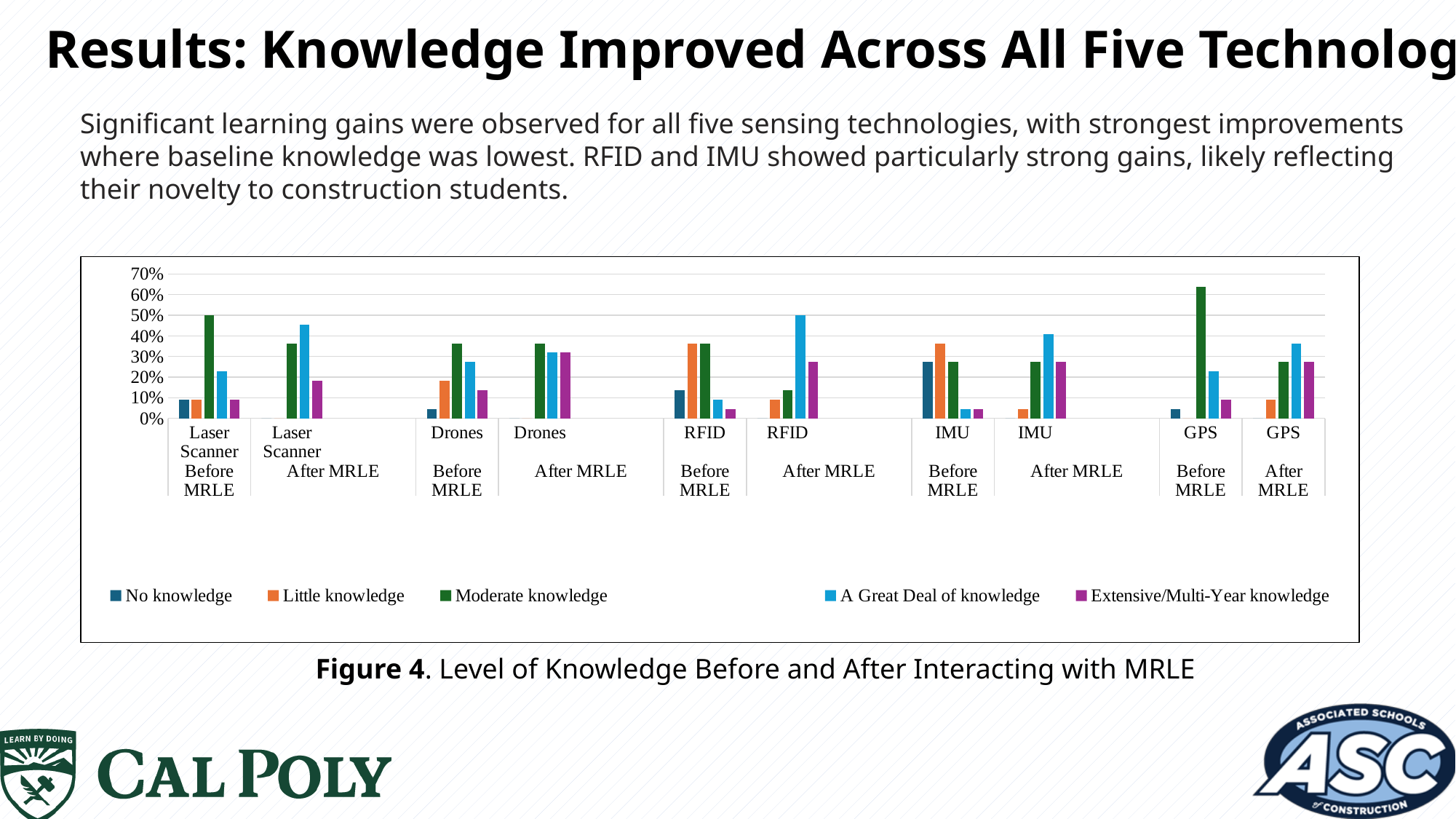
How many series does the chart legend list? 5 Which category group contains the tallest bar in the chart? GPS Before MRLE What kind of chart is shown on the slide? Bar chart Which series has the highest value for GPS Before MRLE? Moderate knowledge How many category groups are shown along the x axis of the chart? 10 Is the A Great Deal of knowledge value for Laser Scanner After MRLE greater or less than 40%? greater For RFID Before MRLE, which is larger: No knowledge or Little knowledge? Little knowledge Is the Extensive/Multi-Year knowledge value for RFID After MRLE greater or less than 30%? less For Laser Scanner Before MRLE, which is larger: Moderate knowledge or A Great Deal of knowledge? Moderate knowledge What is the figure caption below the chart? Figure 4. Level of Knowledge Before and After Interacting with MRLE Is the Moderate knowledge value for GPS Before MRLE greater or less than 60%? greater